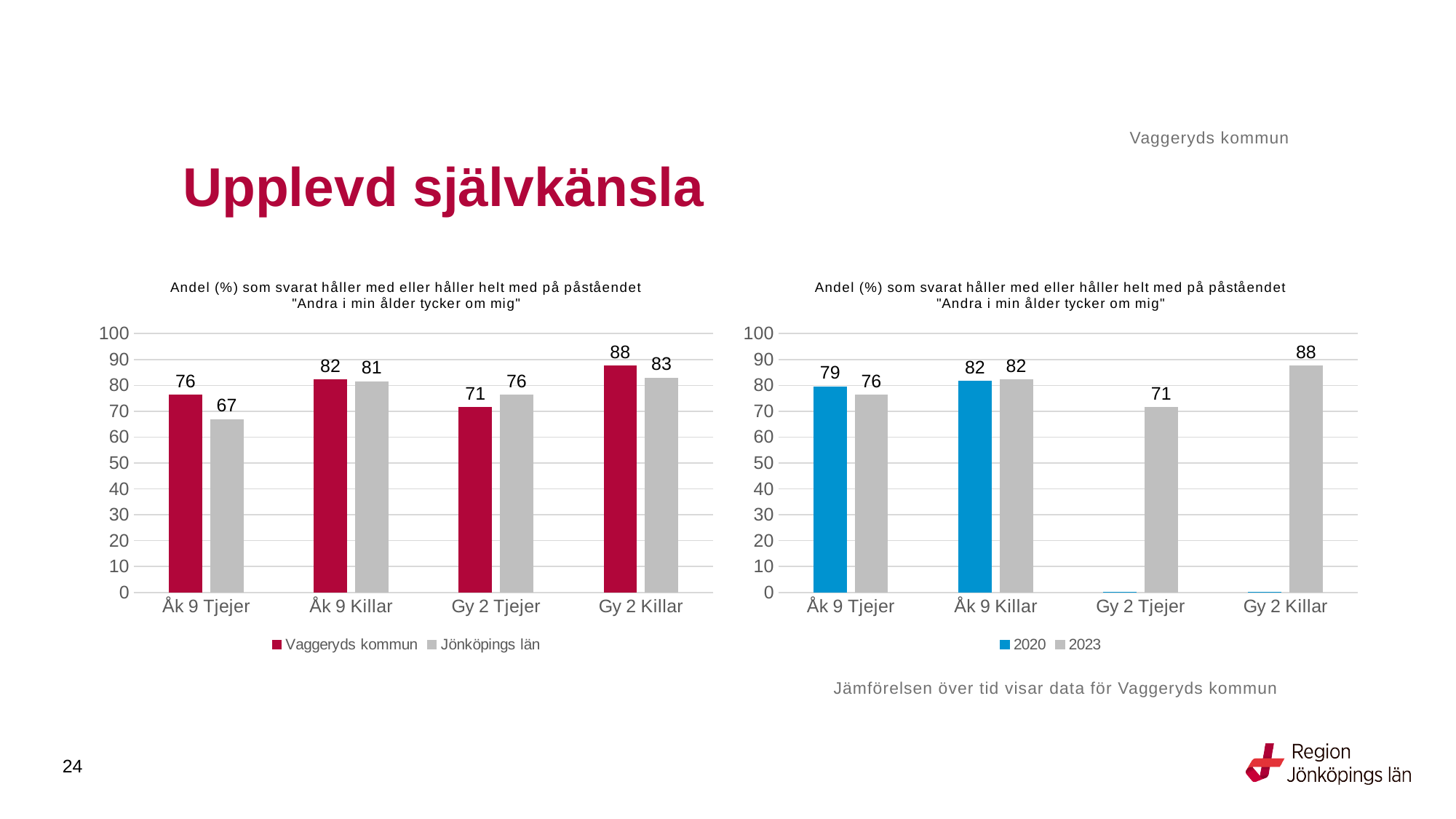
In the right chart, what is the difference between 2020 and 2023 for Åk 9 Tjejer? 3 In the left chart, which category has the highest value for Vaggeryds kommun? Gy 2 Killar In the right chart, what is the value for 2023 for Gy 2 Killar? 88 In the left chart, which is larger for Gy 2 Tjejer: Vaggeryds kommun or Jönköpings län? Jönköpings län In the left chart, what is the value for Jönköpings län for Gy 2 Killar? 83 In the right chart, how many series does the legend list? 2 In the left chart, what is the difference between Vaggeryds kommun and Jönköpings län for Åk 9 Tjejer? 9 What kind of chart is the right chart? Bar chart In the left chart, what is the value for Vaggeryds kommun for Åk 9 Tjejer? 76 How many categories are shown on the x axis of the left chart? 4 In the right chart, what is the value for 2020 for Åk 9 Tjejer? 79 In the left chart, which category has the lowest value for Jönköpings län? Åk 9 Tjejer